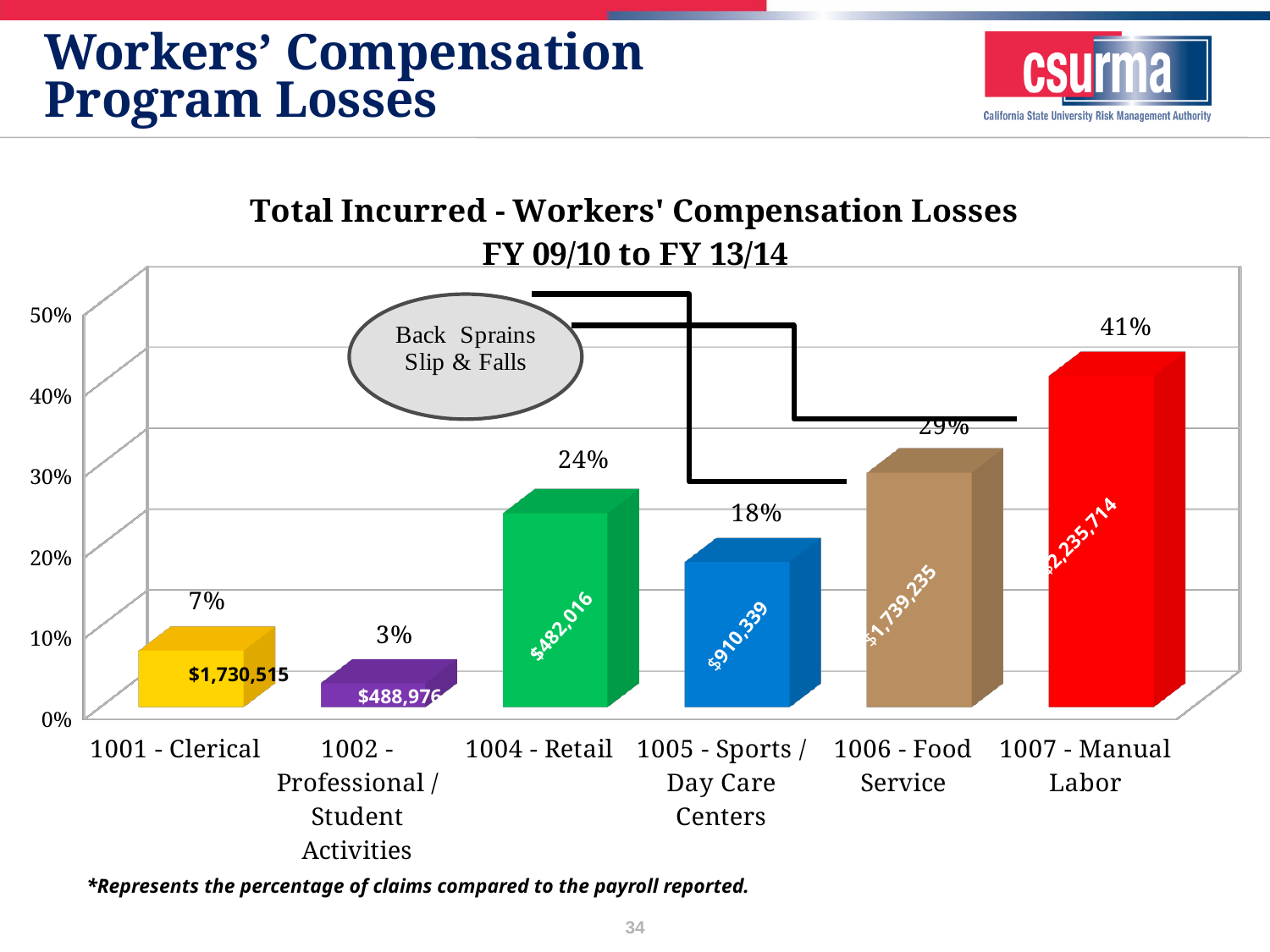
What dollar amount is labeled on the 1006 - Food Service bar? $1,739,235 What is the difference in percentage between 1007 - Manual Labor and 1006 - Food Service? 12% Which has a higher percentage, 1004 - Retail or 1005 - Sports / Day Care Centers? 1004 - Retail What dollar amount is labeled on the 1001 - Clerical bar? $1,730,515 What percentage is shown for 1007 - Manual Labor? 41% What kind of chart is shown on the slide? bar chart What percentage is shown for 1004 - Retail? 24% Which category has the highest percentage? 1007 - Manual Labor Is the percentage for 1006 - Food Service greater or less than 20%? greater How many categories are shown on the x axis? 6 What is the title of the chart? Total Incurred - Workers' Compensation Losses FY 09/10 to FY 13/14 Which category has the lowest percentage? 1002 - Professional / Student Activities